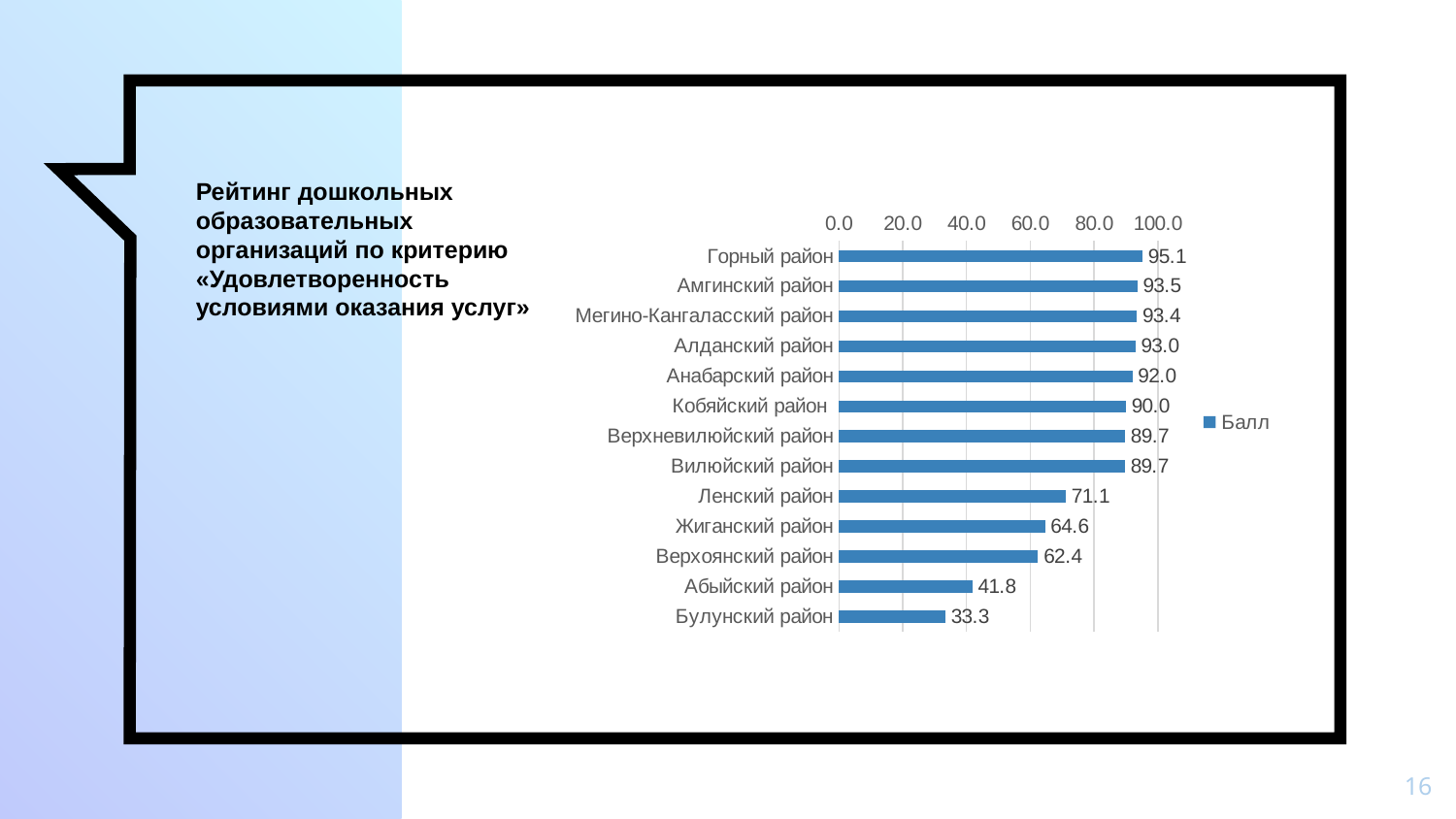
Is the value for Верхоянский район greater or less than 80.0? less What is the value for Ленский район? 71.1 What is the value for Абыйский район? 41.8 Which district has the lowest value? Булунский район What is the difference between the values for Горный район and Булунский район? 61.8 Which district has the highest value? Горный район What kind of chart is shown on the slide? bar chart How many districts are shown in the chart? 13 How many series does the legend list? 1 What is the difference between the values for Жиганский район and Верхоянский район? 2.2 Which is larger, the value for Анабарский район or the value for Кобяйский район? Анабарский район What is the value for Горный район? 95.1